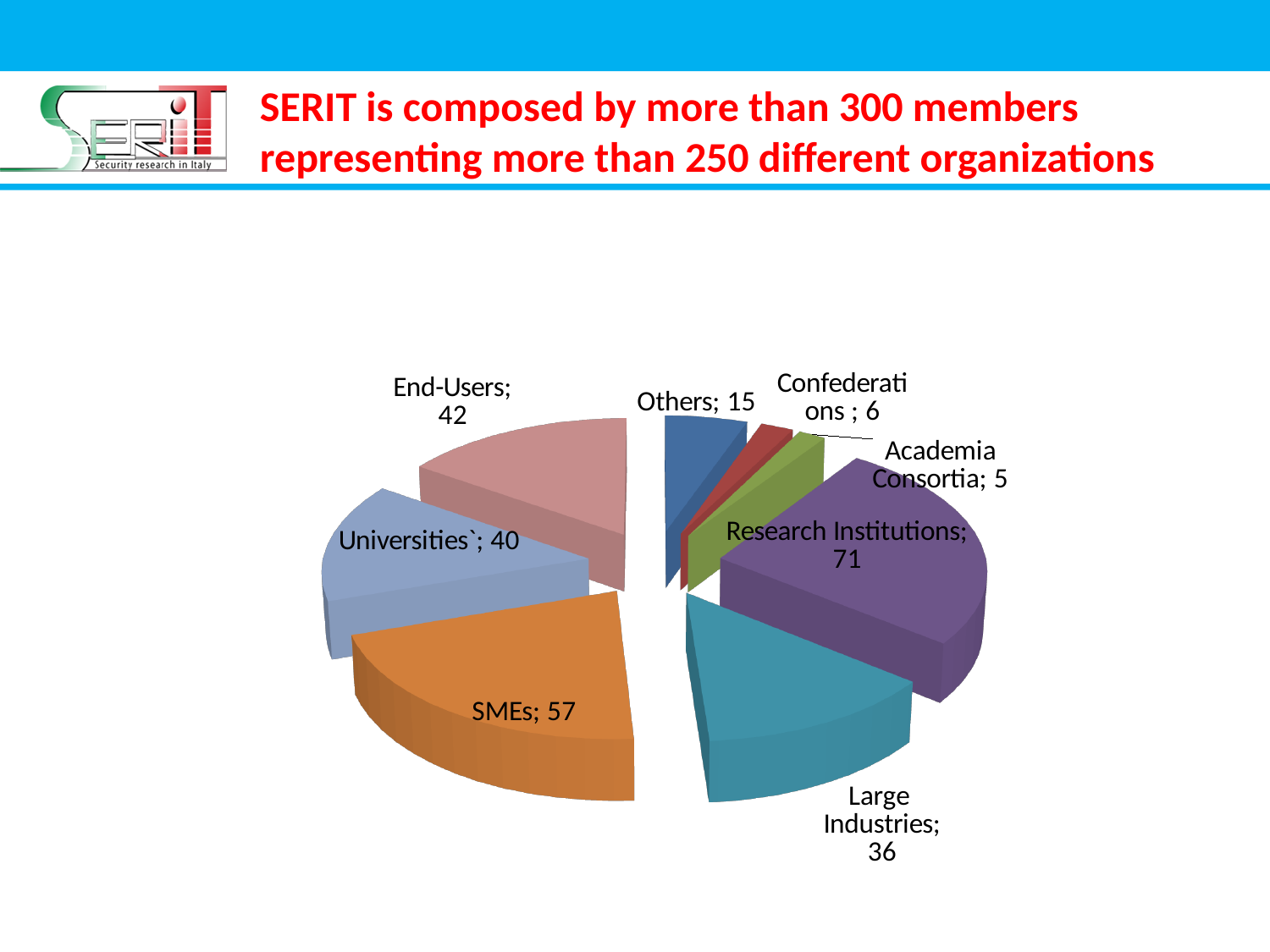
What kind of chart is shown on the slide? pie chart What is the difference between the values for Others and Confederations? 9 What is the value for Large Industries? 36 What is the value for SMEs? 57 What is the value for Academia Consortia? 5 What is the total of all the slices in the pie chart? 272 Which category has the smallest slice? Academia Consortia What is the value for Research Institutions? 71 How many categories does the pie chart show? 8 What is the difference between the values for Research Institutions and SMEs? 14 Which is larger, End-Users or Universities? End-Users Which category has the largest slice? Research Institutions